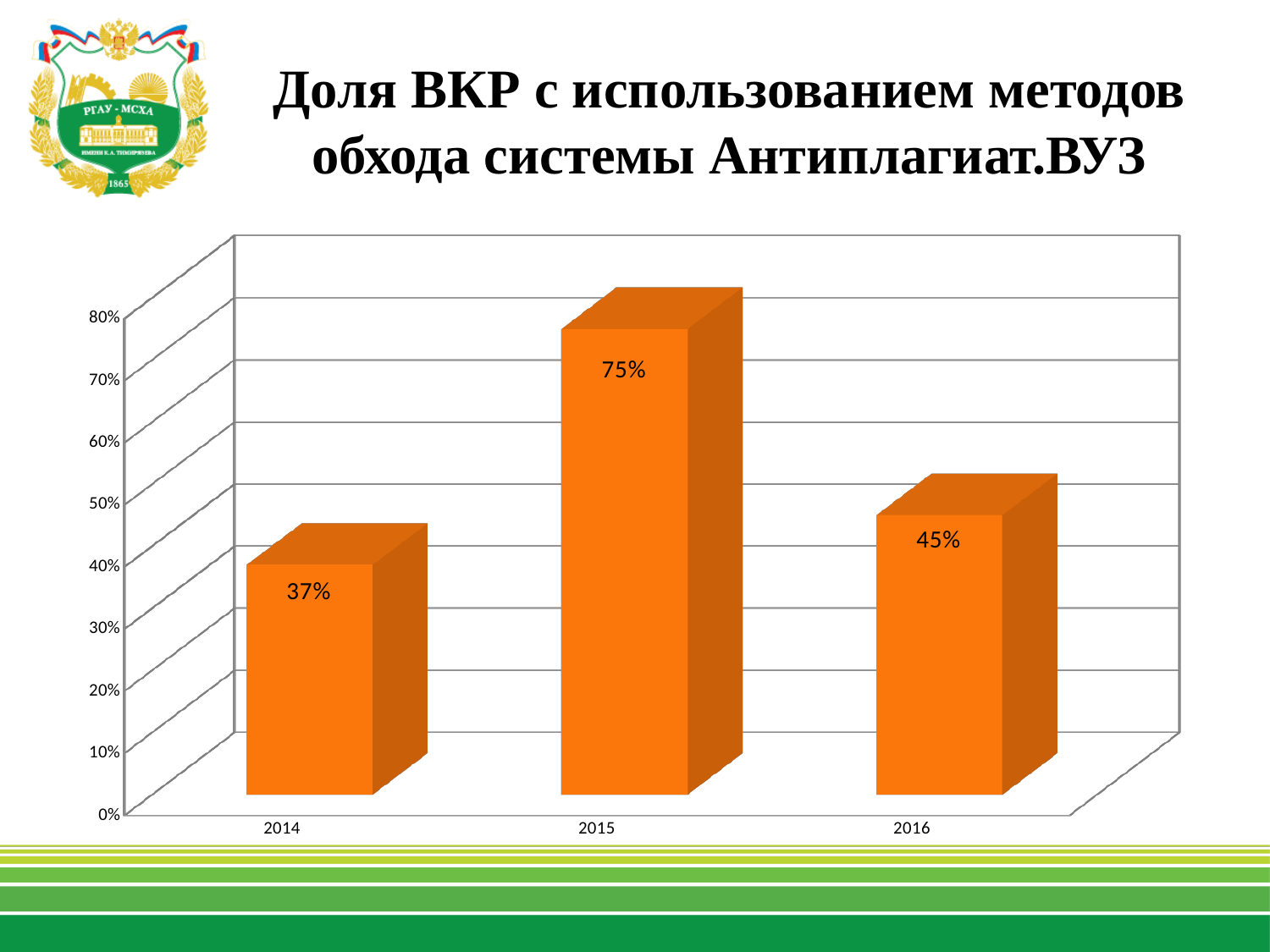
Is the value for 2015 greater or less than 70%? greater What is the value for 2016? 45% What kind of chart is shown on the slide? bar chart What is the value for 2015? 75% What is the value for 2014? 37% How many years are shown on the x axis? 3 Which year has the highest value? 2015 Which is larger, the value for 2016 or the value for 2014? 2016 What is the title of the chart on the slide? Доля ВКР с использованием методов обхода системы Антиплагиат.ВУЗ What is the difference between the values for 2015 and 2016? 30% Which year has the lowest value? 2014 What is the difference between the values for 2015 and 2014? 38%